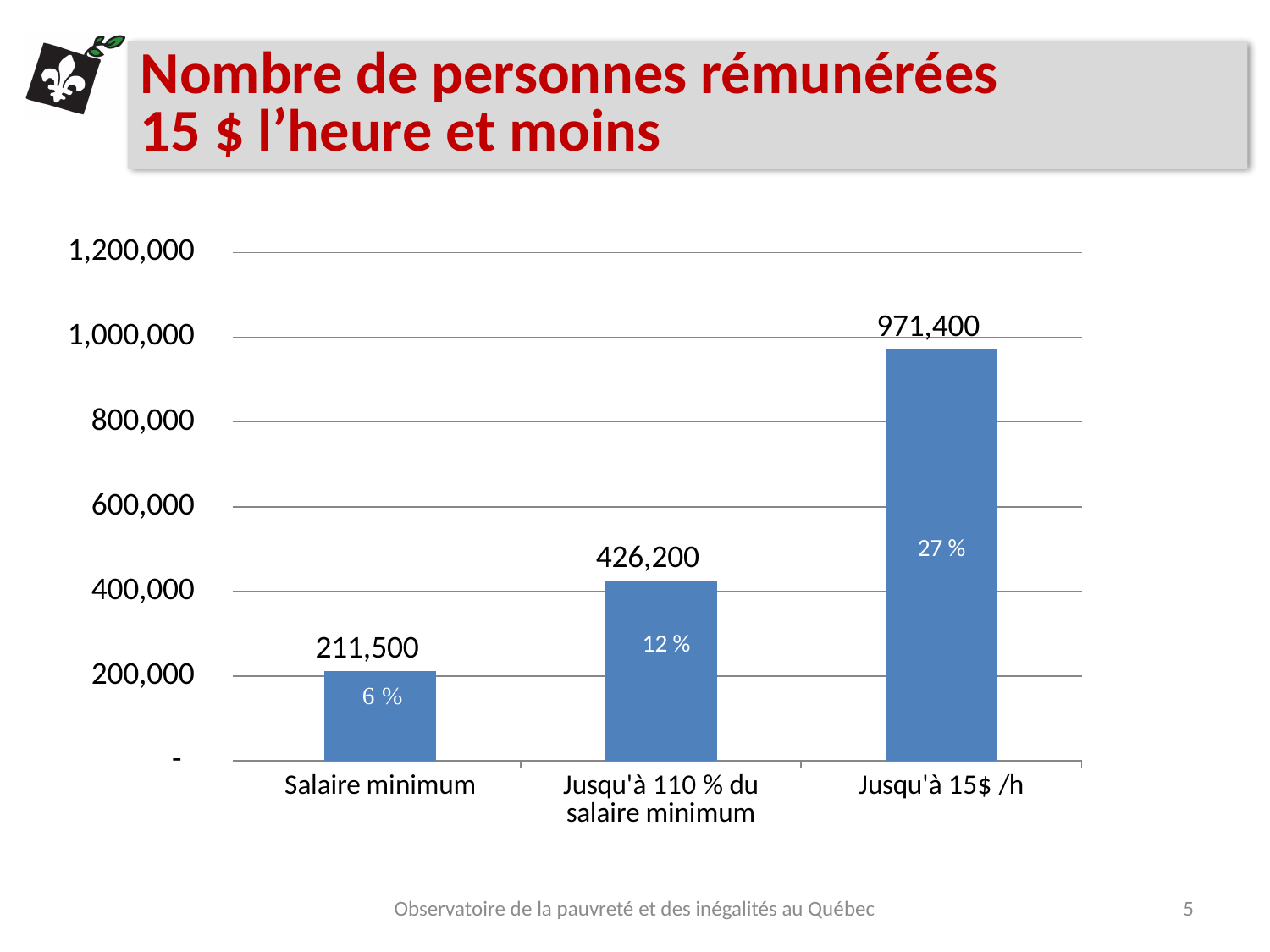
Which category has the lowest value? Salaire minimum What percentage label is printed inside the bar for Jusqu'à 15$ /h? 27 % Which category has the highest value? Jusqu'à 15$ /h How many categories are shown on the x axis? 3 What is the difference between the values for Jusqu'à 15$ /h and Jusqu'à 110 % du salaire minimum? 545,200 What is the value for Jusqu'à 110 % du salaire minimum? 426,200 What kind of chart is shown on the slide? bar chart What is the value for Jusqu'à 15$ /h? 971,400 What is the value for Salaire minimum? 211,500 What is the difference between the values for Jusqu'à 110 % du salaire minimum and Salaire minimum? 214,700 Is the value for Jusqu'à 15$ /h greater or less than 1,000,000? less Which is larger, the value for Salaire minimum or the value for Jusqu'à 110 % du salaire minimum? Jusqu'à 110 % du salaire minimum